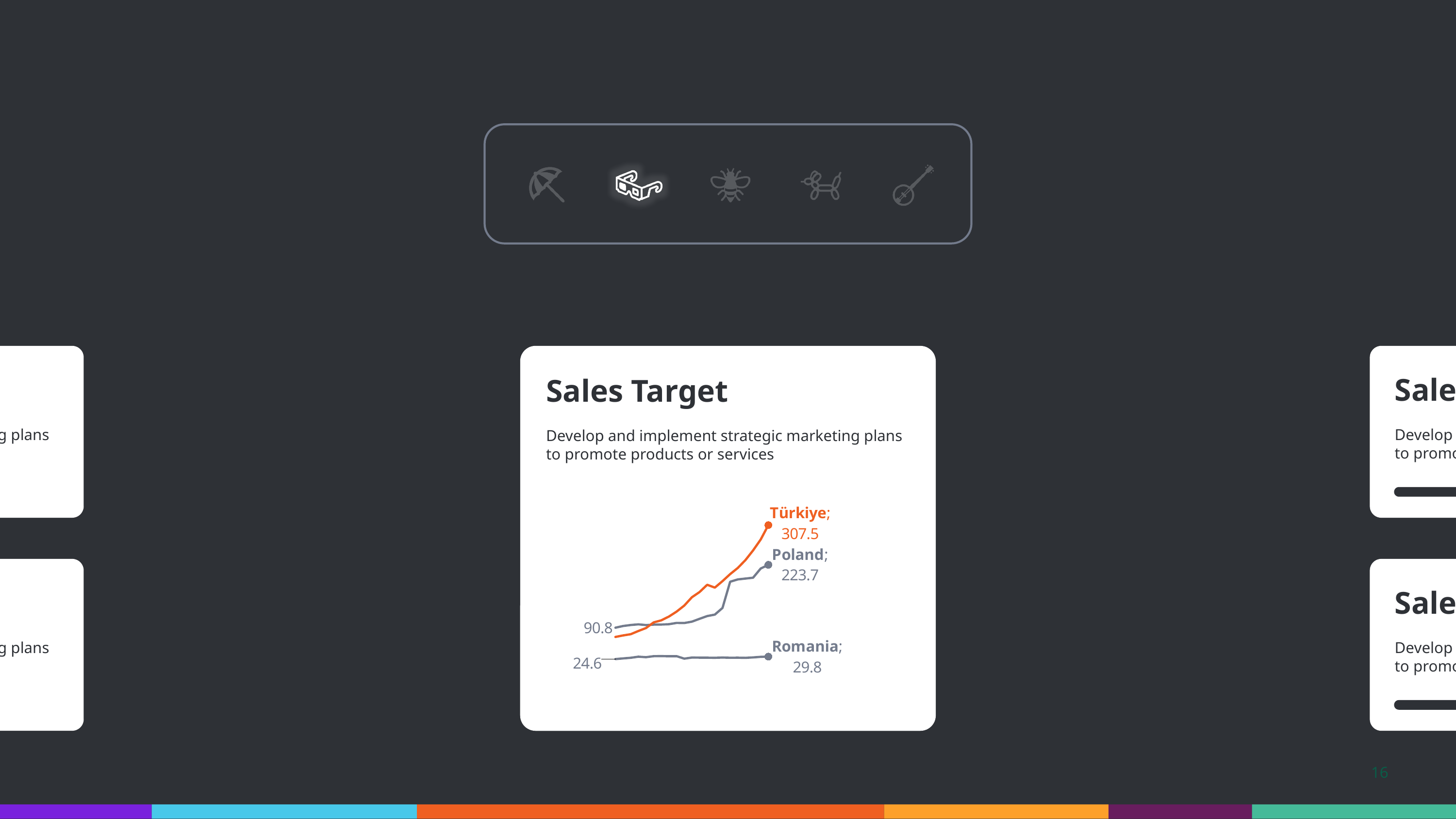
Which country ends with the lowest value on the Sales Target chart? Romania Which country ends with the highest value on the Sales Target chart? Türkiye Which has a larger final value on the Sales Target chart, Poland or Romania? Poland What is the difference between the final values of Türkiye and Poland on the Sales Target chart? 83.8 By how much does Romania's value change from its labelled start (24.6) to its end (29.8)? 5.2 What is the final value shown for Türkiye on the Sales Target chart? 307.5 How many lines (series) are plotted on the Sales Target chart? 3 Does the Türkiye line rise or fall from left to right on the Sales Target chart? Rise What is the starting value labelled for Romania on the Sales Target chart? 24.6 What kind of chart is shown on the Sales Target card? Line chart What is the final value shown for Romania on the Sales Target chart? 29.8 What is the final value shown for Poland on the Sales Target chart? 223.7